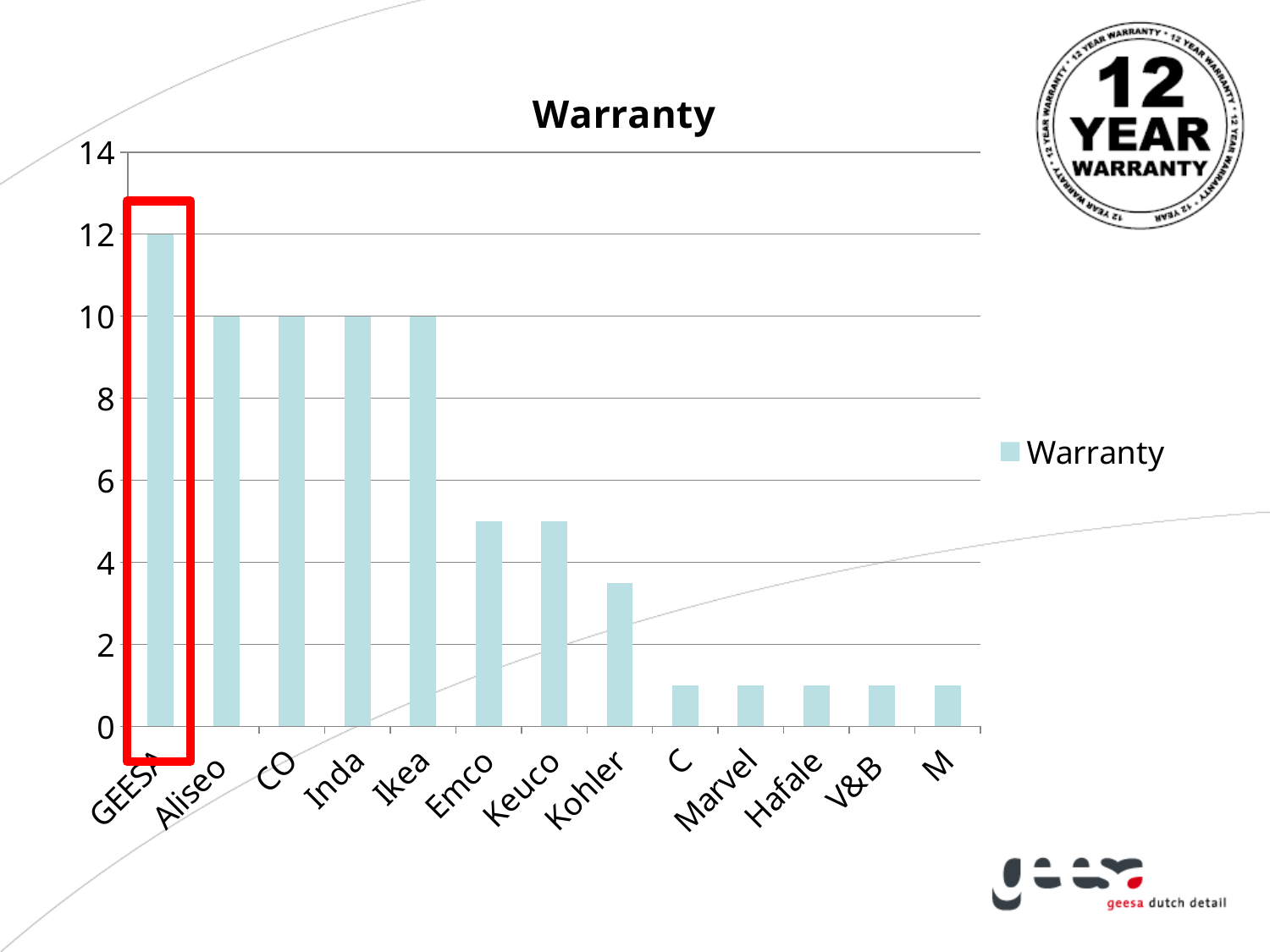
What is the warranty value for GEESA? 12 Do the values generally rise or fall moving from left to right along the x axis? fall Is the value for Kohler greater or less than 4? less How many series does the legend list? 1 What type of chart is shown on the slide? bar chart Which category has the highest warranty value? GEESA What is the warranty value for Aliseo? 10 Which has a larger warranty value, Ikea or Emco? Ikea How many categories are shown on the x axis? 13 What is the title of the chart? Warranty Is the value for Emco greater or less than 4? greater What is the difference between the warranty values for GEESA and Inda? 2